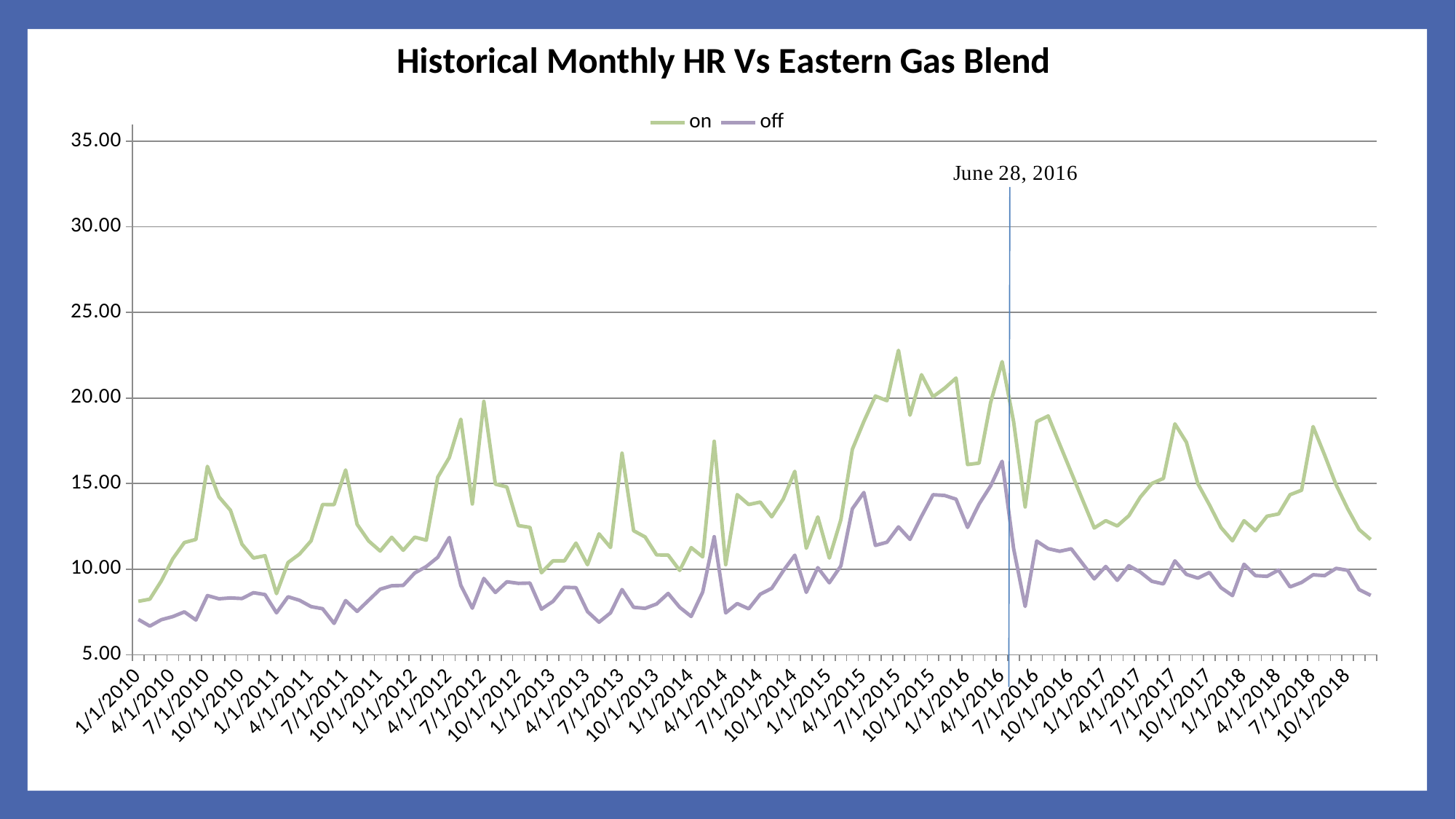
Does the on series rise or fall between 7/1/2018 and the end of the chart? fall Is the value of the on series at 1/1/2010 greater or less than 10.00? less Which series reaches the highest value on the chart, on or off? on What kind of chart is shown on the slide? line chart At 1/1/2010, which series has the larger value, on or off? on At 7/1/2015, which series has the larger value, on or off? on What is the title of the chart? Historical Monthly HR Vs Eastern Gas Blend What date is annotated by the vertical line on the chart? June 28, 2016 Is the value of the off series at 4/1/2016 greater or less than 10.00? greater Which series has the lowest value on the chart, on or off? off How many series does the legend list? 2 Is the value of the on series at 4/1/2015 greater or less than 15.00? greater